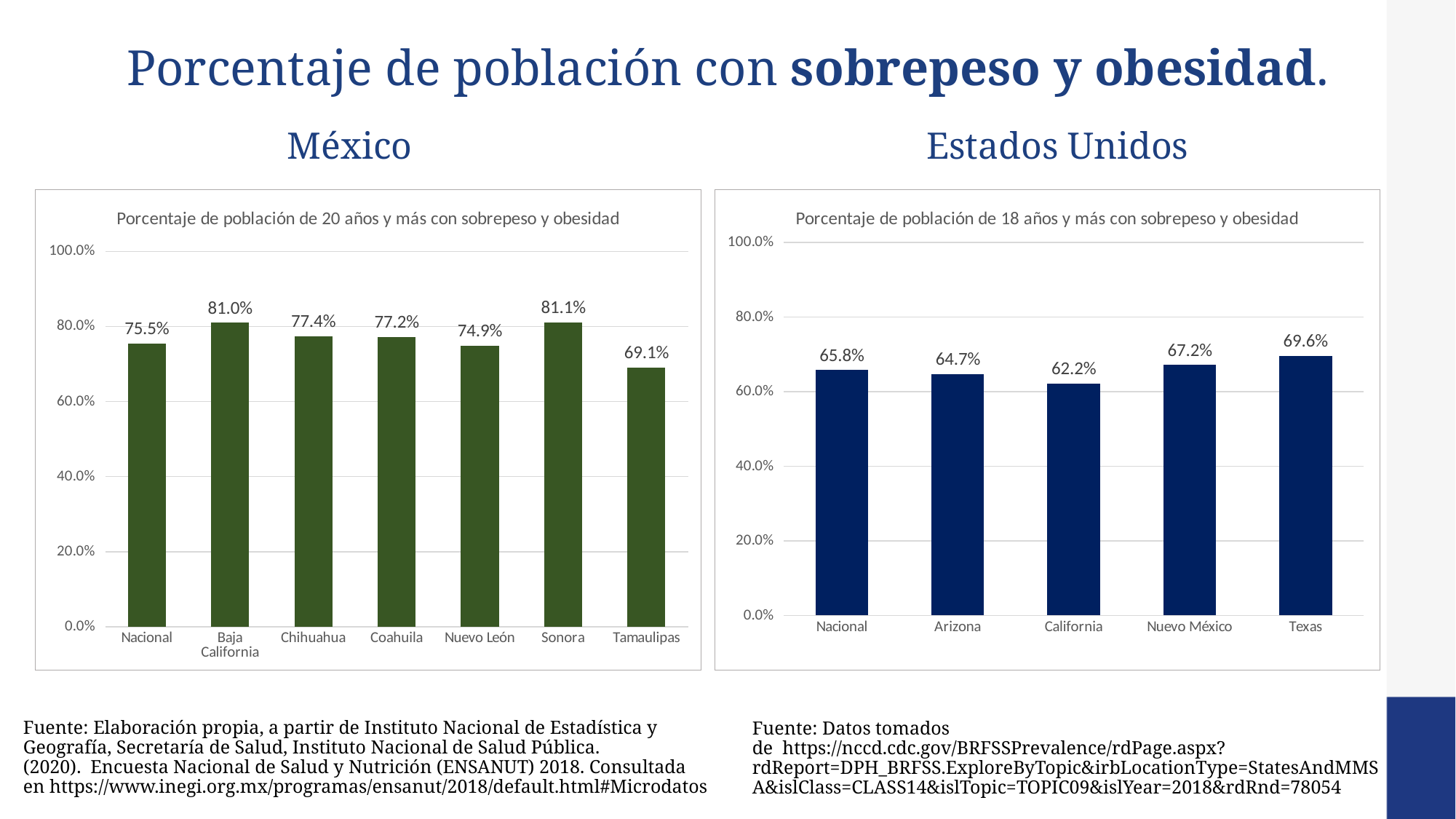
In the México chart, what is the difference between the values for Chihuahua and Nuevo León? 2.5% In the Estados Unidos chart, what is the value for Nuevo México? 67.2% In the Estados Unidos chart, which category has the lowest value? California In the Estados Unidos chart, which category has the highest value? Texas In the México chart, what is the value for Tamaulipas? 69.1% In the Estados Unidos chart, what is the difference between the values for Texas and California? 7.4% How many categories are shown in the México chart? 7 How many categories are shown in the Estados Unidos chart? 5 What kind of chart is the Estados Unidos chart? Bar chart In the México chart, which category has the lowest value? Tamaulipas In the México chart, which is larger, the value for Nacional or the value for Coahuila? Coahuila In the Estados Unidos chart, is the value for Arizona greater or less than 60.0%? greater